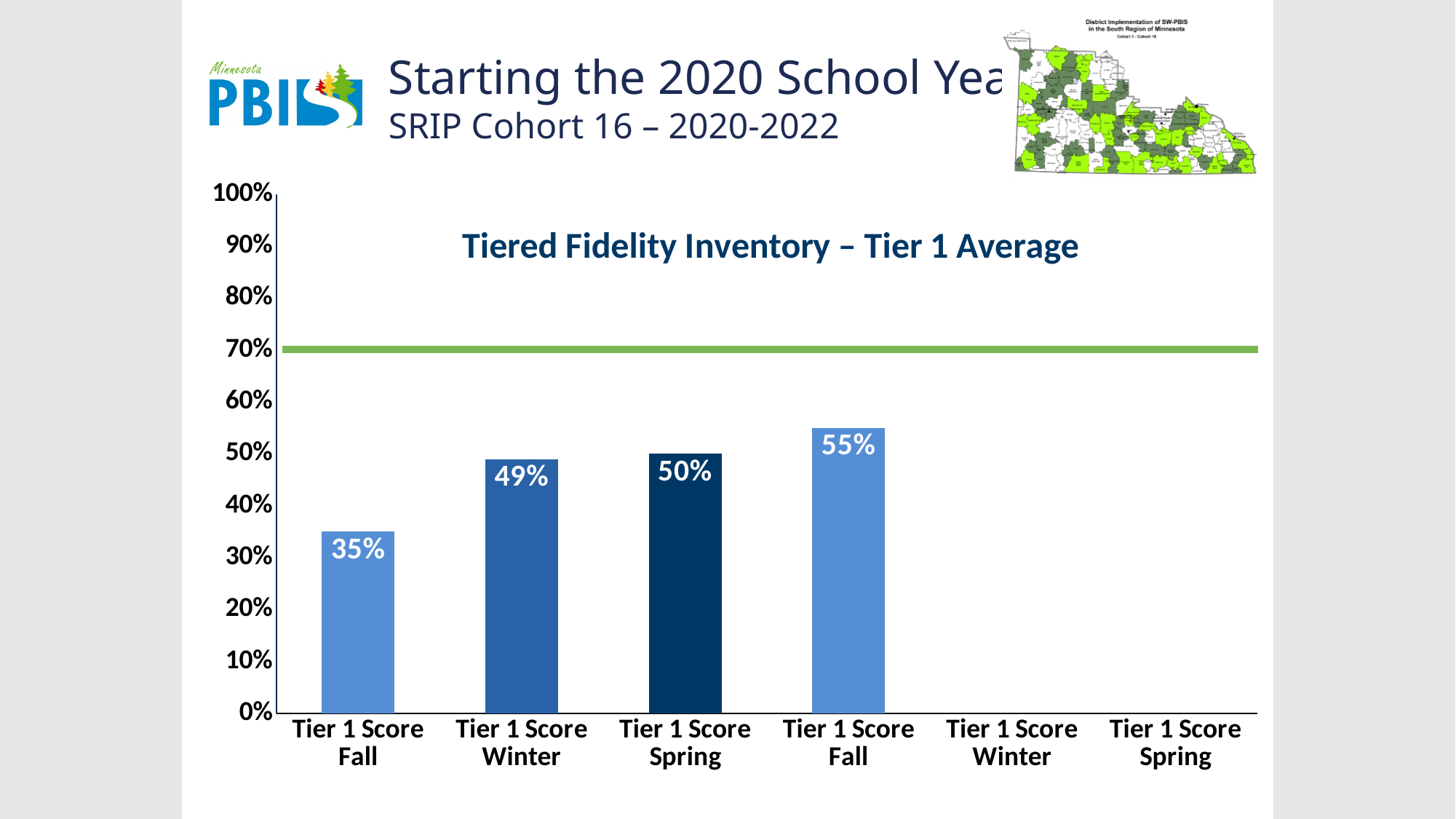
What is the title of the chart? Tiered Fidelity Inventory – Tier 1 Average What kind of chart is shown on the slide? bar chart What is the value of the Tier 1 Score Winter bar? 49% What is the value of the Tier 1 Score Spring bar? 50% Do the plotted bar values rise or fall from left to right? rise What is the value of the first Tier 1 Score Fall bar (the leftmost bar)? 35% Which is larger, the Tier 1 Score Winter bar or the first Tier 1 Score Fall bar? Tier 1 Score Winter Which bar has the highest value? the second Tier 1 Score Fall bar (55%) What is the value of the second Tier 1 Score Fall bar (the fourth bar from the left)? 55% How many category labels are shown along the x axis? 6 What is the difference between the second Tier 1 Score Fall bar (55%) and the first Tier 1 Score Fall bar (35%)? 20% Which bar has the lowest value? the first Tier 1 Score Fall bar (35%)